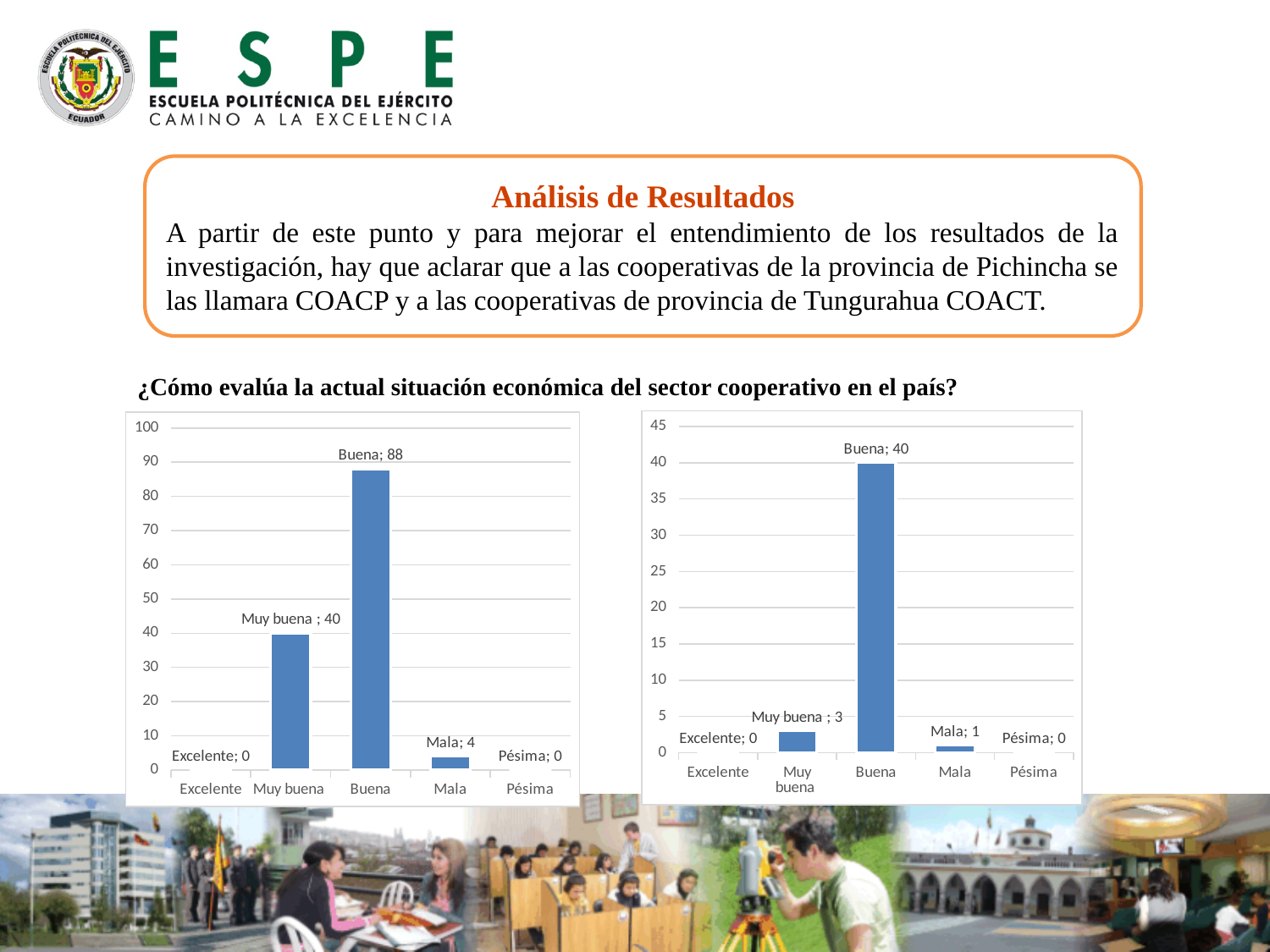
In the right chart, which category has the highest value? Buena In the left chart, is the value for Buena greater or less than 80? greater In the left chart, which is larger, the value for Mala or the value for Muy buena? Muy buena In the left chart, what is the difference between the values for Buena and Muy buena? 48 In the left chart, what is the value for Muy buena? 40 In the left chart, which category has the highest value? Buena What kind of chart is the left chart? Bar chart In the right chart, what is the value for Muy buena? 3 In the right chart, what is the value for Mala? 1 In the right chart, what is the difference between the values for Buena and Muy buena? 37 How many categories are shown in the right chart? 5 In the left chart, what is the value for Buena? 88